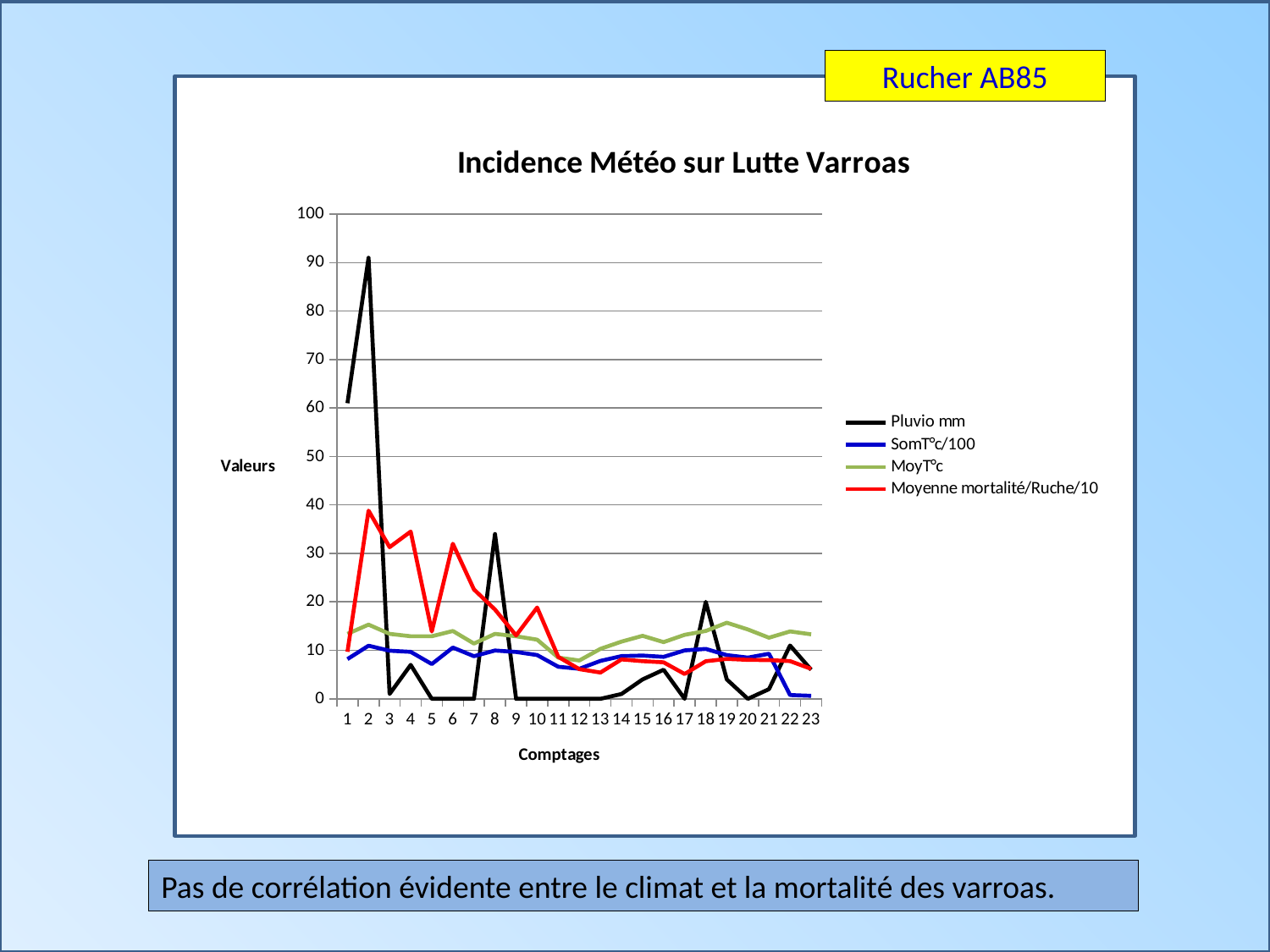
At which comptage does the Moyenne mortalité/Ruche/10 series reach its highest value? 2 What is the title of the chart? Incidence Météo sur Lutte Varroas Is the Pluvio mm value at comptage 8 greater or less than 30? greater What kind of chart is shown on the slide? line chart How many comptages (points) are shown along the x axis? 23 How many series does the legend list? 4 Is the Pluvio mm value at comptage 2 greater or less than 80? greater What is the Pluvio mm value at comptage 5? 0 At comptage 1, which is larger: Pluvio mm or Moyenne mortalité/Ruche/10? Pluvio mm Is the Moyenne mortalité/Ruche/10 value at comptage 2 greater or less than 30? greater Does the Moyenne mortalité/Ruche/10 series rise or fall from comptage 10 to comptage 13? fall At which comptage does the Pluvio mm series reach its highest value? 2